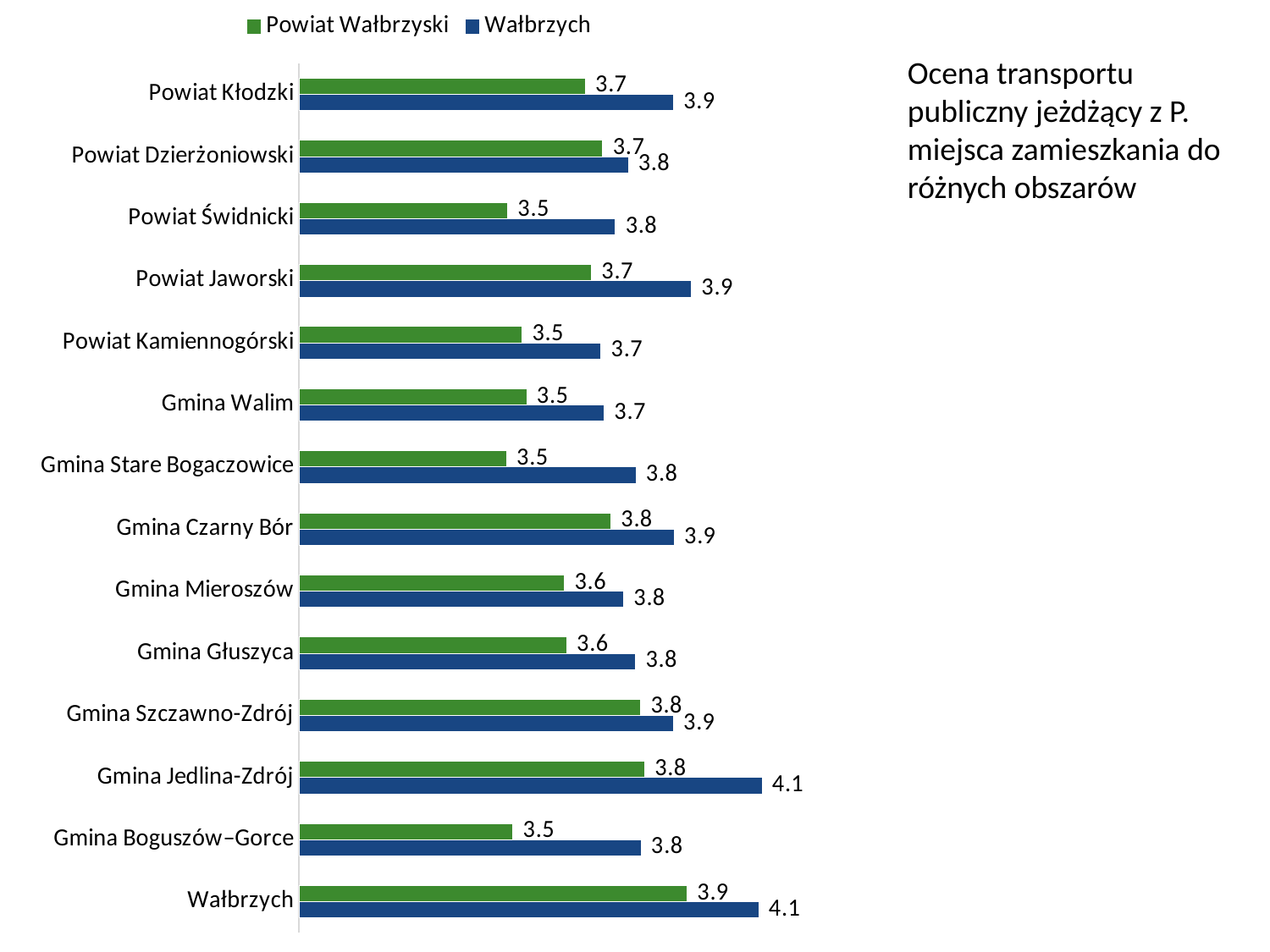
What is the value for Gmina Jedlina-Zdrój in the Powiat Wałbrzyski series? 3.8 What kind of chart is shown on the slide? Bar chart For Gmina Walim, which series has the larger value, Powiat Wałbrzyski or Wałbrzych? Wałbrzych How many series does the legend list? 2 What is the value for Powiat Kłodzki in the Wałbrzych series? 3.9 Which series is shown in green? Powiat Wałbrzyski What is the difference between the Wałbrzych and Powiat Wałbrzyski values for Wałbrzych? 0.2 How many categories are shown on the chart? 14 Which category has the highest value in the Powiat Wałbrzyski series? Wałbrzych What is the value for Gmina Mieroszów in the Wałbrzych series? 3.8 What is the difference between the Wałbrzych and Powiat Wałbrzyski values for Gmina Jedlina-Zdrój? 0.3 What is the value for Powiat Świdnicki in the Powiat Wałbrzyski series? 3.5